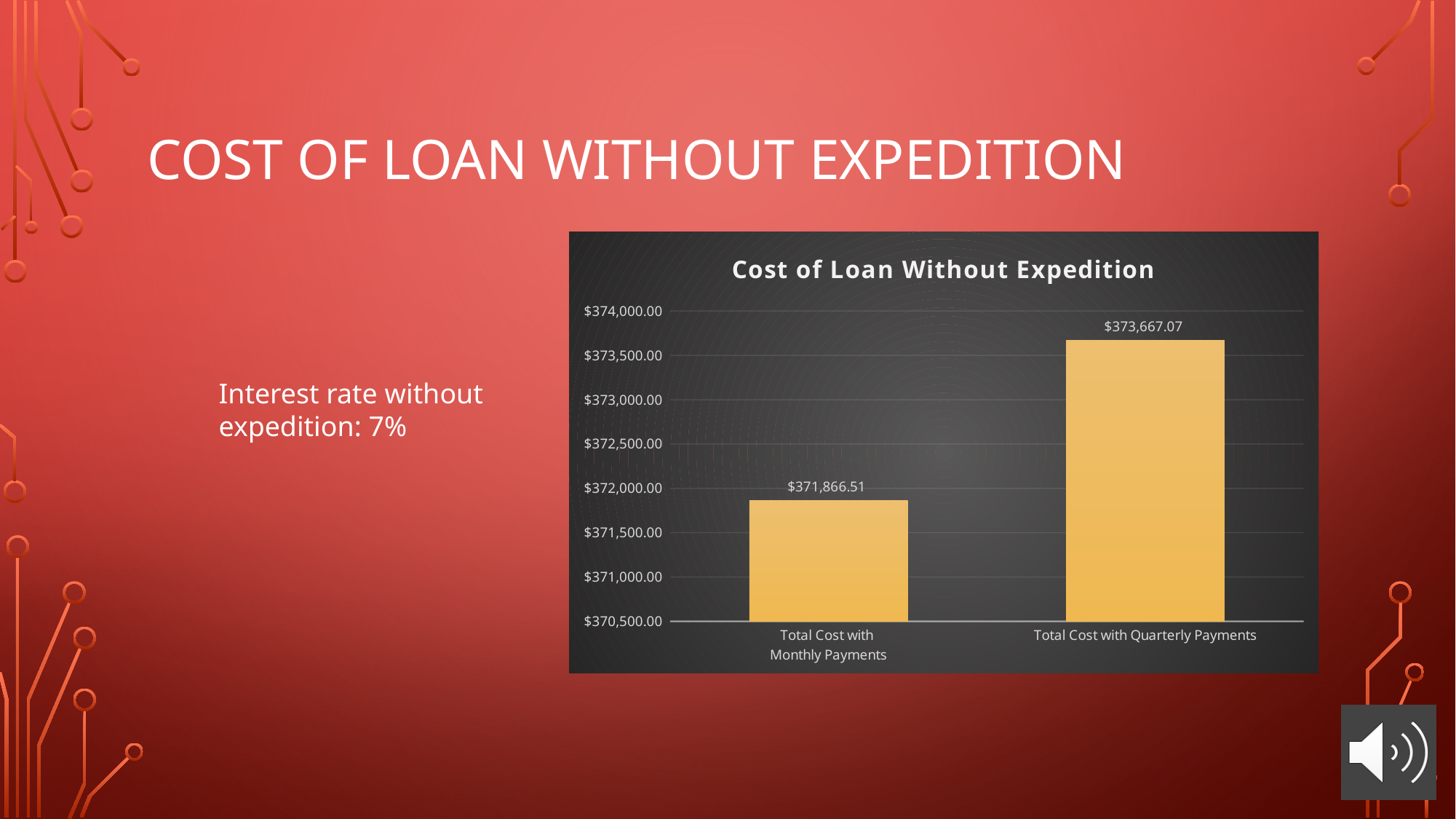
How many categories are shown in the chart? 2 Which category has the highest value? Total Cost with Quarterly Payments What is the difference between Total Cost with Quarterly Payments and Total Cost with Monthly Payments? $1,800.56 What is the value for Total Cost with Quarterly Payments? $373,667.07 Which category has the lowest value? Total Cost with Monthly Payments What kind of chart is shown on the slide? Bar chart Is the value for Total Cost with Quarterly Payments greater or less than $373,500.00? greater What is the value for Total Cost with Monthly Payments? $371,866.51 What is the title of the chart? Cost of Loan Without Expedition Which is larger, Total Cost with Monthly Payments or Total Cost with Quarterly Payments? Total Cost with Quarterly Payments Is the value for Total Cost with Monthly Payments greater or less than $372,000.00? less What is the highest value shown on the vertical axis? $374,000.00